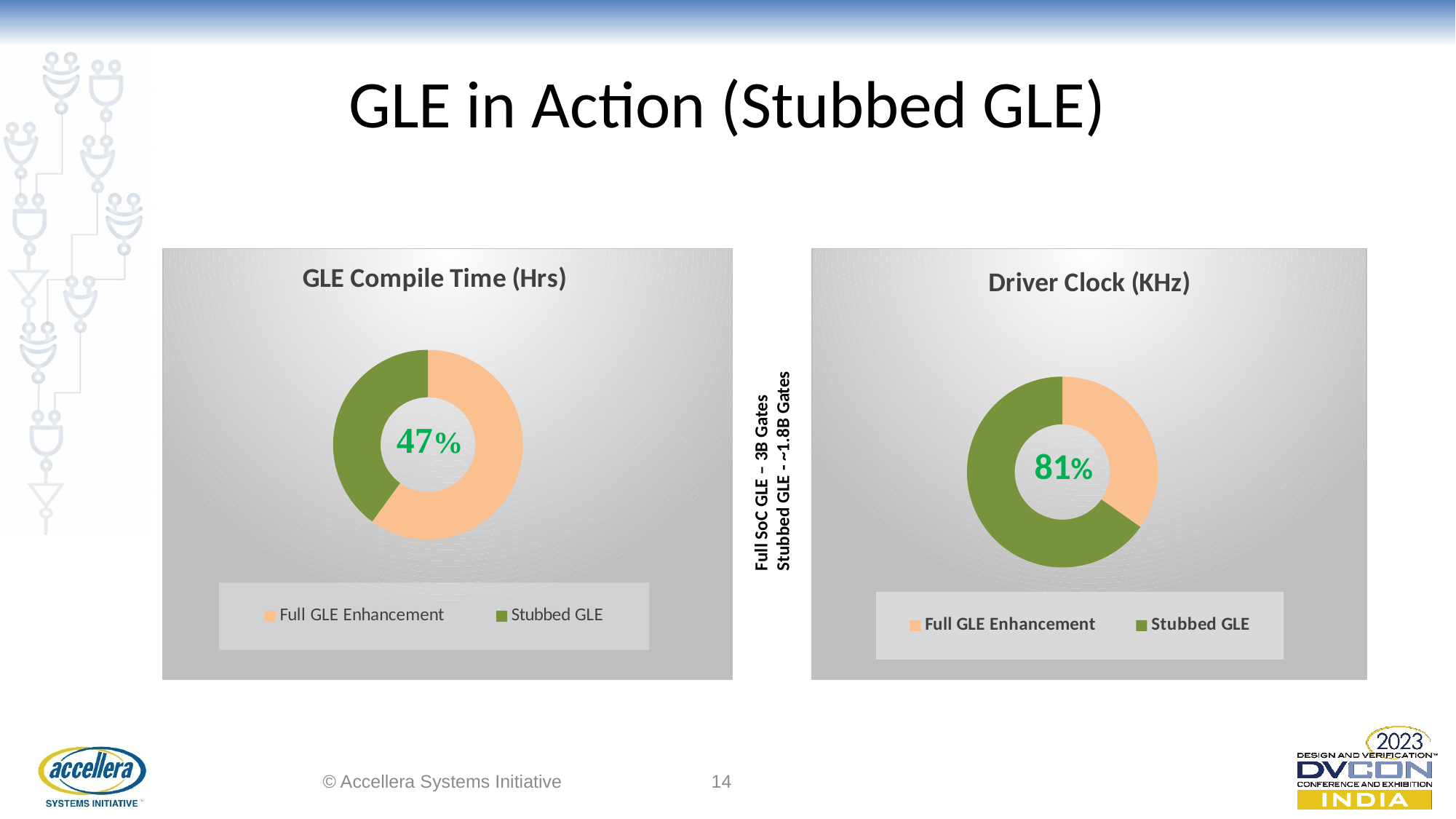
How many slices does the "Driver Clock (KHz)" chart have? 2 In the "Driver Clock (KHz)" chart, which category has the largest slice? Stubbed GLE What percentage is printed in the centre of the "Driver Clock (KHz)" chart? 81% What is the title of the chart on the left of the slide? GLE Compile Time (Hrs) What kind of chart is the "GLE Compile Time (Hrs)" chart? Doughnut chart What percentage is printed in the centre of the "GLE Compile Time (Hrs)" chart? 47% What kind of chart is the "Driver Clock (KHz)" chart? Doughnut chart In the "Driver Clock (KHz)" chart, which colour represents Stubbed GLE? Green In the "Driver Clock (KHz)" chart, which slice is larger, Full GLE Enhancement or Stubbed GLE? Stubbed GLE In the "GLE Compile Time (Hrs)" chart, which category has the smallest slice? Stubbed GLE How many entries does the legend of the "GLE Compile Time (Hrs)" chart list? 2 In the "GLE Compile Time (Hrs)" chart, which slice is larger, Full GLE Enhancement or Stubbed GLE? Full GLE Enhancement